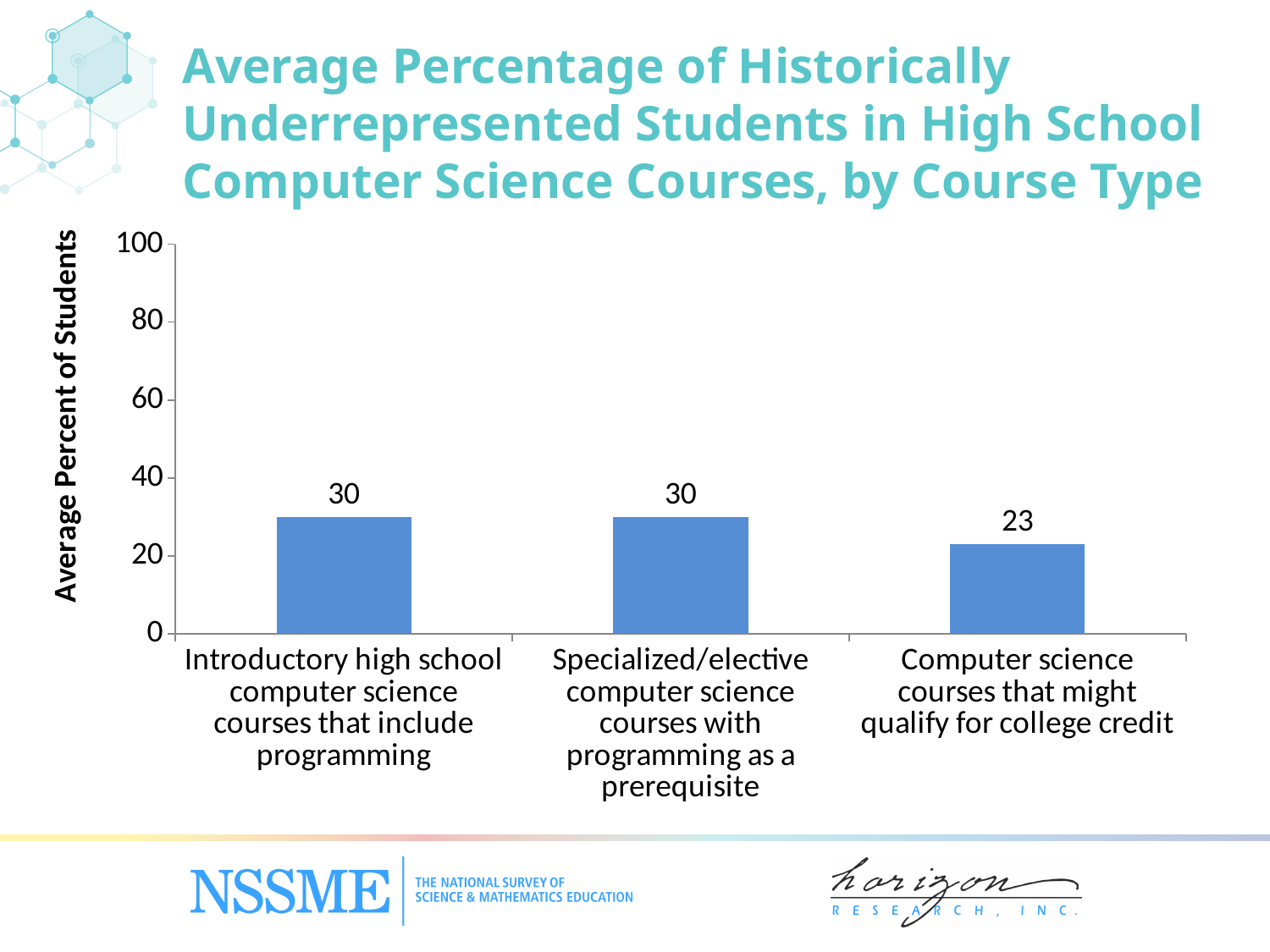
What is the average percent of historically underrepresented students in computer science courses that might qualify for college credit? 23 Is the value for computer science courses that might qualify for college credit greater or less than 40? less What is the difference between the value for introductory high school computer science courses that include programming and the value for computer science courses that might qualify for college credit? 7 Do the values rise or fall from the second bar to the third bar along the x axis? fall How many course types are shown on the chart? 3 Which is larger: the value for specialized/elective computer science courses with programming as a prerequisite or the value for computer science courses that might qualify for college credit? Specialized/elective computer science courses with programming as a prerequisite What is the label of the vertical axis? Average Percent of Students What kind of chart is shown on the slide? Bar chart Which course type has the lowest average percent of historically underrepresented students? Computer science courses that might qualify for college credit What is the average percent of historically underrepresented students in specialized/elective computer science courses with programming as a prerequisite? 30 What is the average percent of historically underrepresented students in introductory high school computer science courses that include programming? 30 What is the maximum value shown on the vertical axis? 100